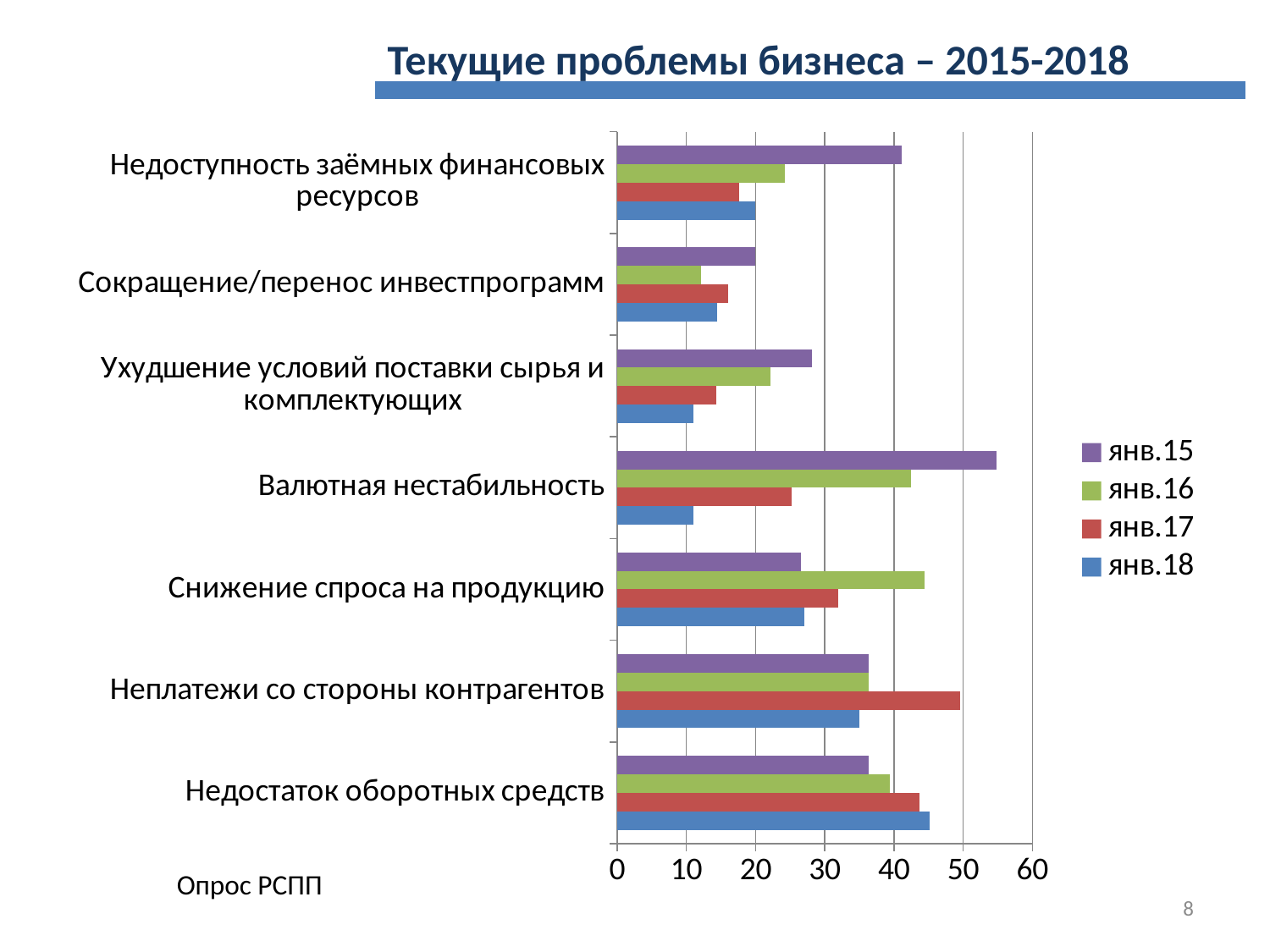
Is the янв.16 value for Сокращение/перенос инвестпрограмм greater or less than 20? less What is the title of the chart on the slide? Текущие проблемы бизнеса – 2015-2018 For Неплатежи со стороны контрагентов, which is larger: the янв.17 value or the янв.18 value? янв.17 Which category has the highest value for янв.18? Недостаток оборотных средств How many problem categories are plotted on the chart? 7 What kind of chart is shown on the slide? bar chart Is the янв.15 value for Валютная нестабильность greater or less than 50? greater How many series does the legend list? 4 For Снижение спроса на продукцию, which is larger: the янв.15 value or the янв.16 value? янв.16 Which category has the highest value for янв.15? Валютная нестабильность Do the values for Валютная нестабильность rise or fall from янв.15 to янв.18? fall Which category has the lowest value for янв.16? Сокращение/перенос инвестпрограмм